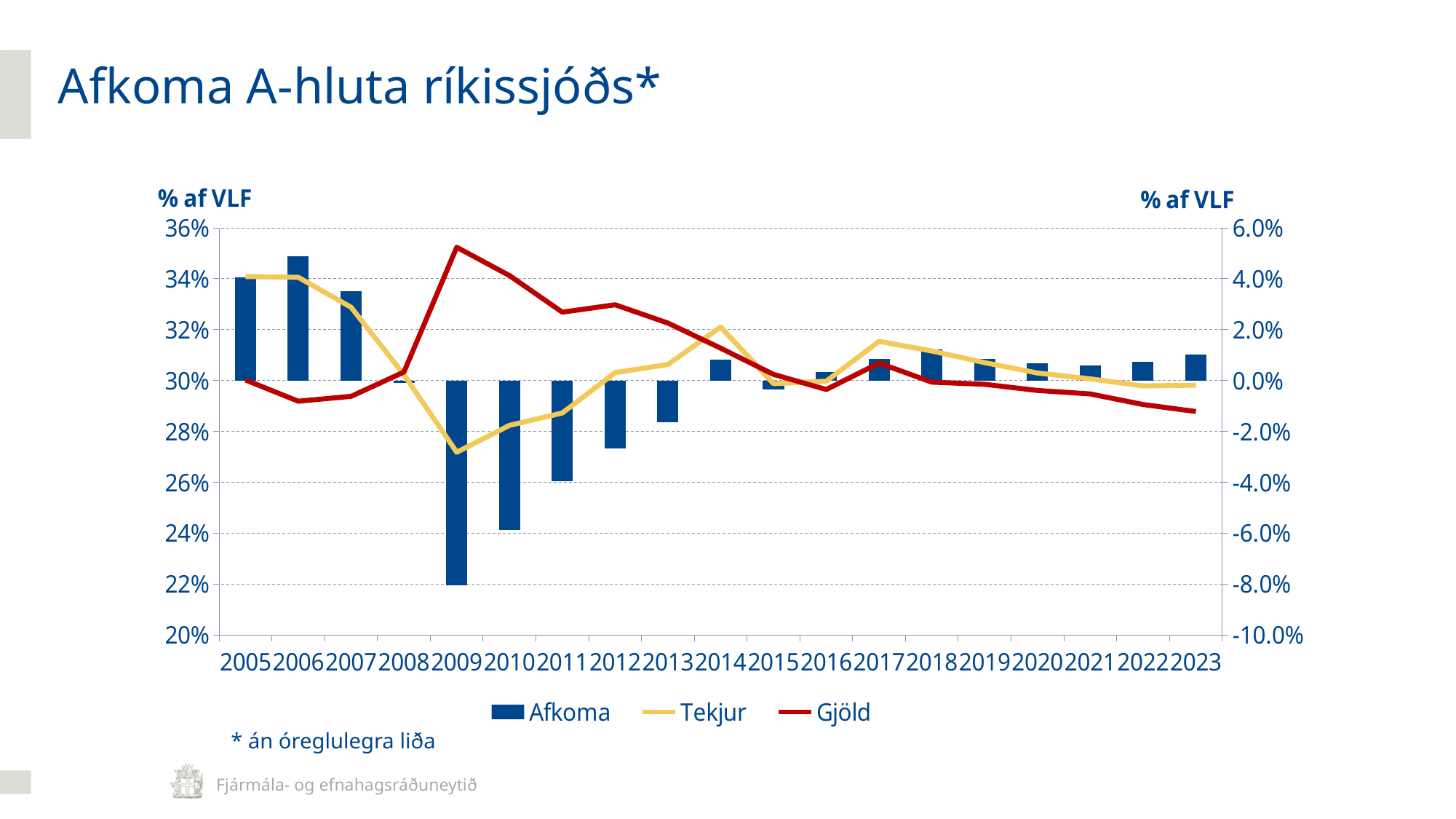
How many years are shown on the x axis? 19 What are the three series named in the legend? Afkoma, Tekjur, Gjöld Which year has the larger Afkoma value, 2010 or 2011? 2011 Is the Afkoma value for 2009 greater or less than -6.0%? less Does the Gjöld line rise or fall from 2017 to 2023? Fall What kind of chart is shown on the slide? A combined bar and line chart Is the Afkoma value for 2006 greater or less than 4.0%? greater How many series does the legend list? 3 In which year is the Afkoma bar lowest? 2009 In which year is the Afkoma bar highest? 2006 In which year does the Gjöld line reach its peak? 2009 In 2009, which line is higher, Tekjur or Gjöld? Gjöld